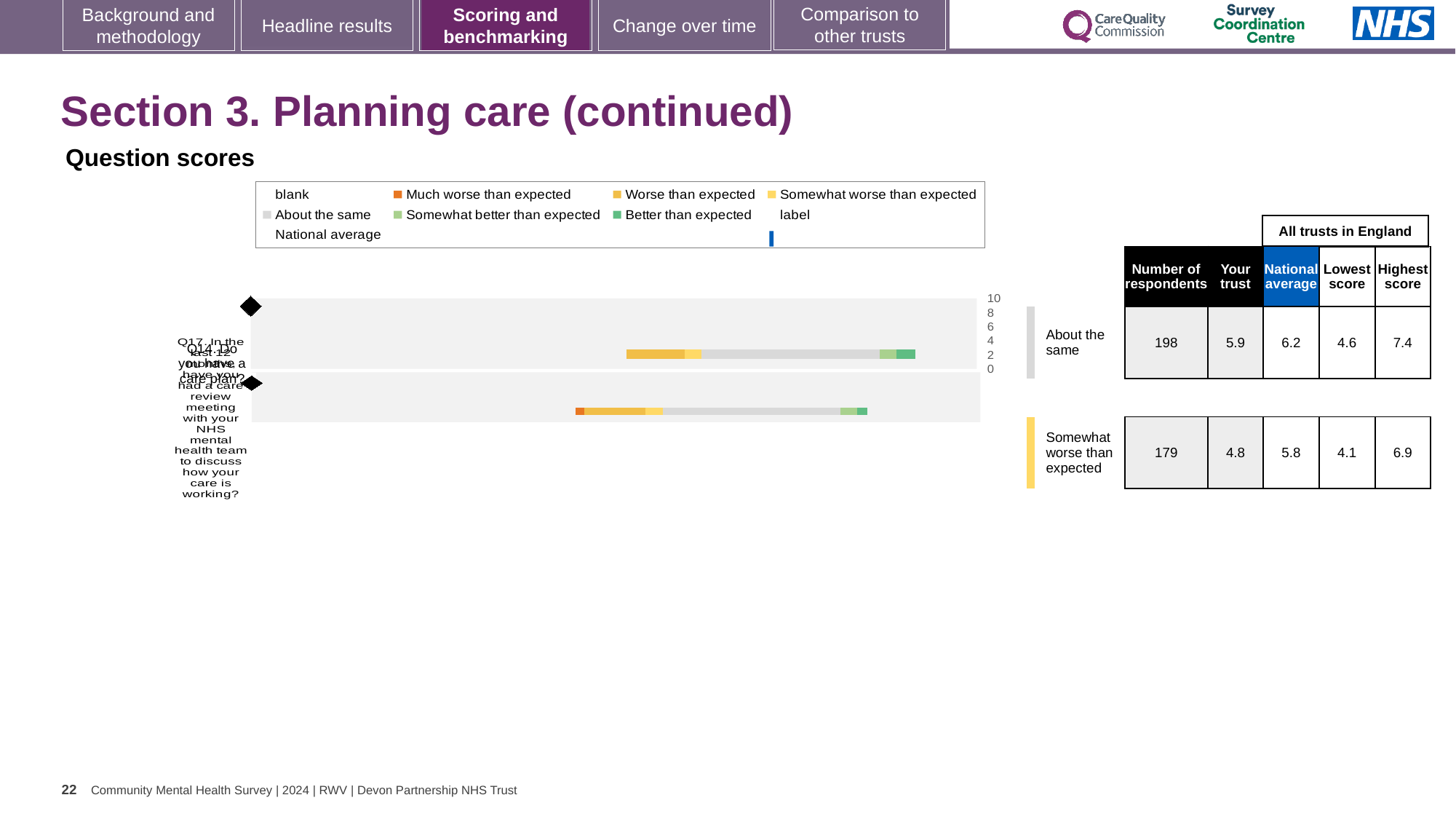
In the table next to the chart, what is the 'Your trust' score for the row rated 'Somewhat worse than expected'? 4.8 In the table next to the chart, what is the lowest score among all trusts in England for the row rated 'About the same'? 4.6 In the table next to the chart, what is the national average for the row rated 'About the same'? 6.2 In the table next to the chart, what is the highest score among all trusts in England for the row rated 'Somewhat worse than expected'? 6.9 In the table next to the chart, what is the number of respondents for the row rated 'About the same'? 198 Which row has more respondents: 'About the same' or 'Somewhat worse than expected'? About the same How many question bars are plotted in the chart? 2 What is the difference between the national average and the 'Your trust' score for the row rated 'Somewhat worse than expected'? 1.0 What kind of chart is shown under 'Question scores'? bar chart Which row has the larger 'Your trust' score: 'About the same' or 'Somewhat worse than expected'? About the same What is the difference between the highest score and the lowest score for the row rated 'About the same'? 2.8 What colour is used in the legend for 'Much worse than expected'? orange